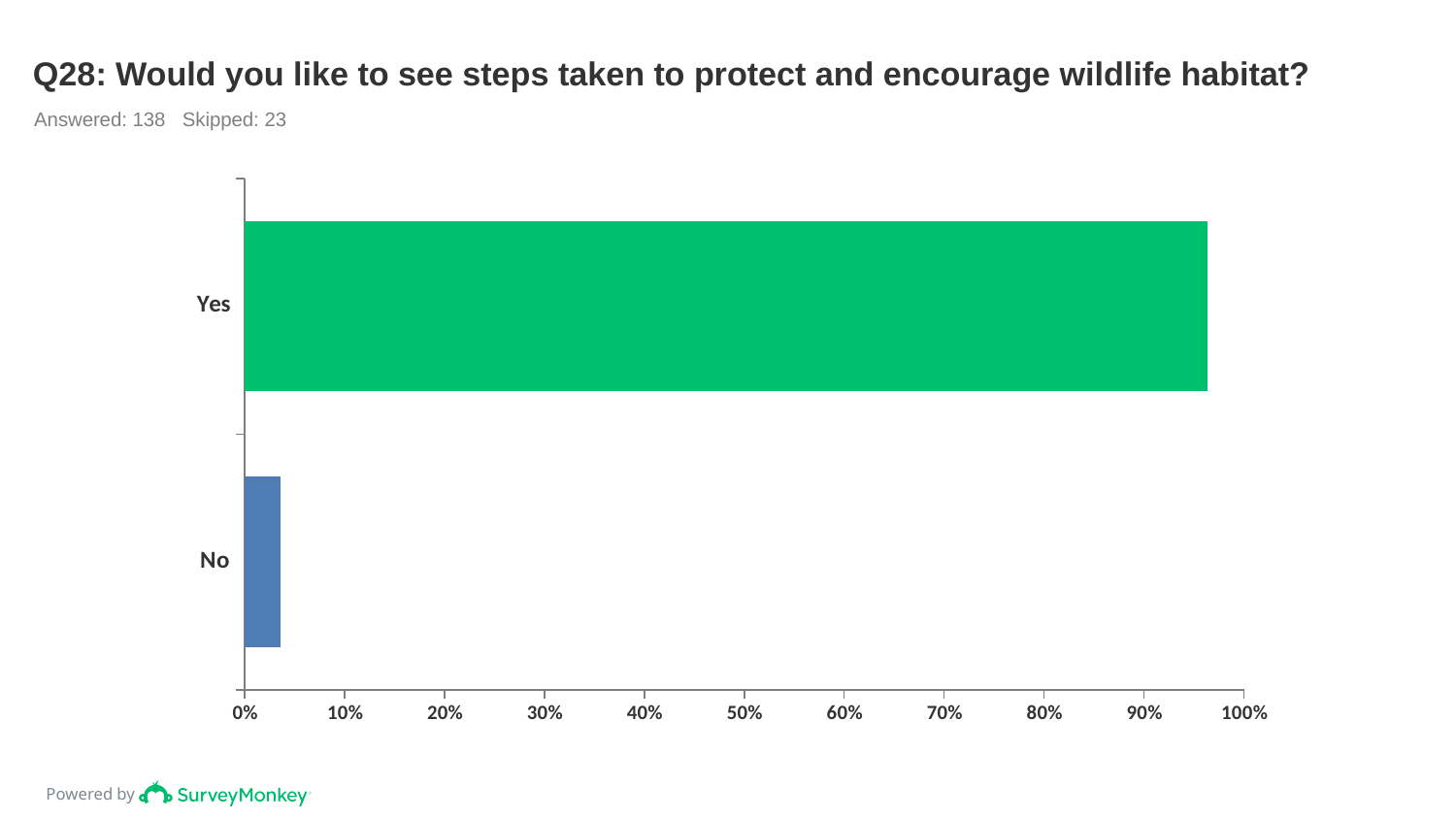
Which category has the highest value? Yes What is the maximum value shown on the x axis? 100% How many respondents answered this question according to the slide? 138 Is the value for Yes greater or less than 50%? greater Which is larger, the value for Yes or the value for No? Yes What kind of chart is shown on the slide? bar chart Is the value for No greater or less than 10%? less Which category has the lowest value? No How many categories are plotted in the chart? 2 Is the value for Yes greater or less than 90%? greater What is the title of the chart? Q28: Would you like to see steps taken to protect and encourage wildlife habitat?